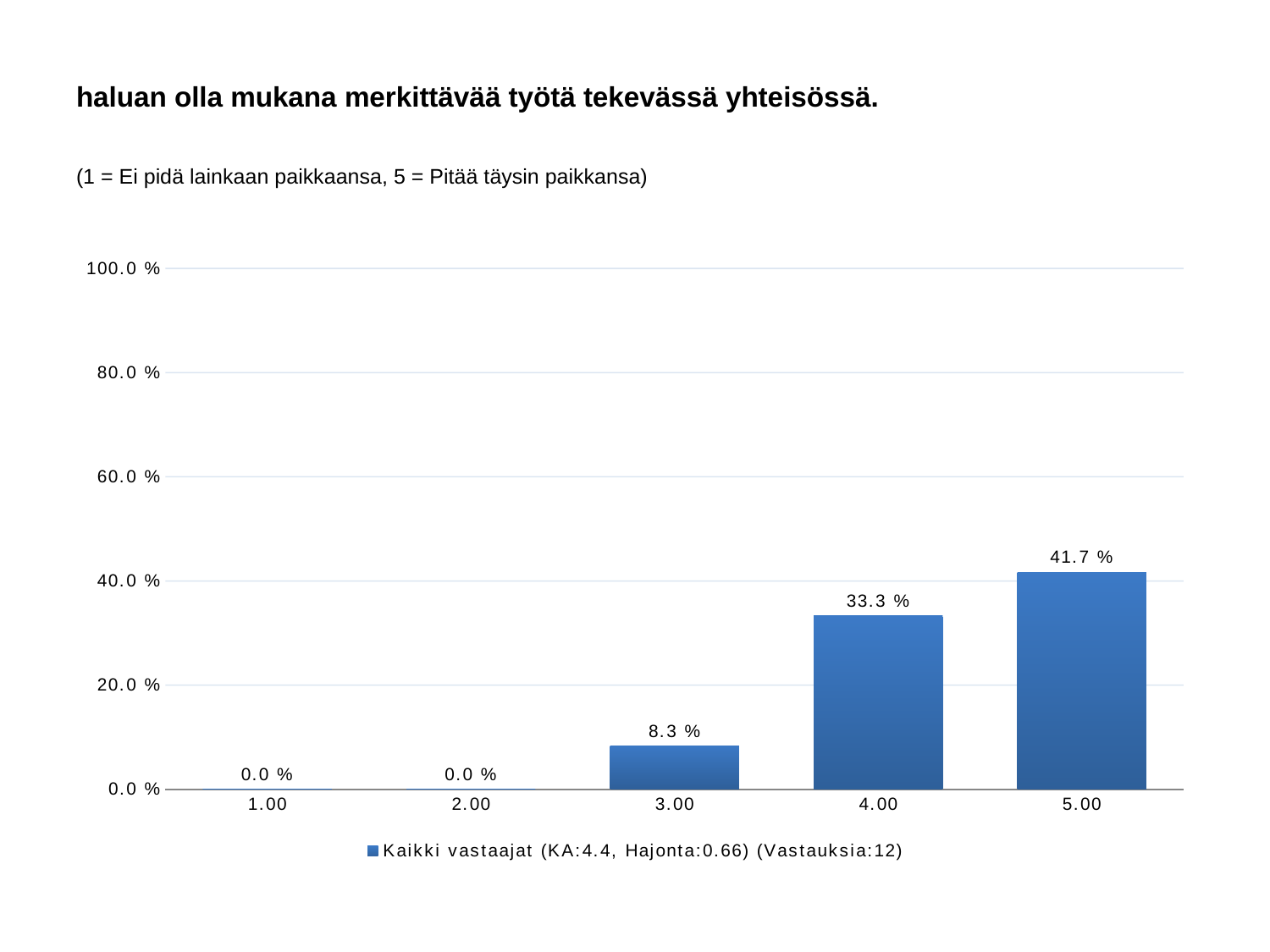
What is the value for category 5.00? 41.7 % Which category has the highest value? 5.00 How many categories are shown on the x axis? 5 What kind of chart is shown? bar chart What is the difference between the values for 5.00 and 4.00? 8.4 % What is the value for category 4.00? 33.3 % How many series does the legend list? 1 Do the values rise or fall from category 1.00 to 5.00? rise What is the value for category 1.00? 0.0 % What is the value for category 3.00? 8.3 % Is the value for 5.00 greater or less than 40.0 %? greater Which is larger, the value for 3.00 or the value for 4.00? 4.00